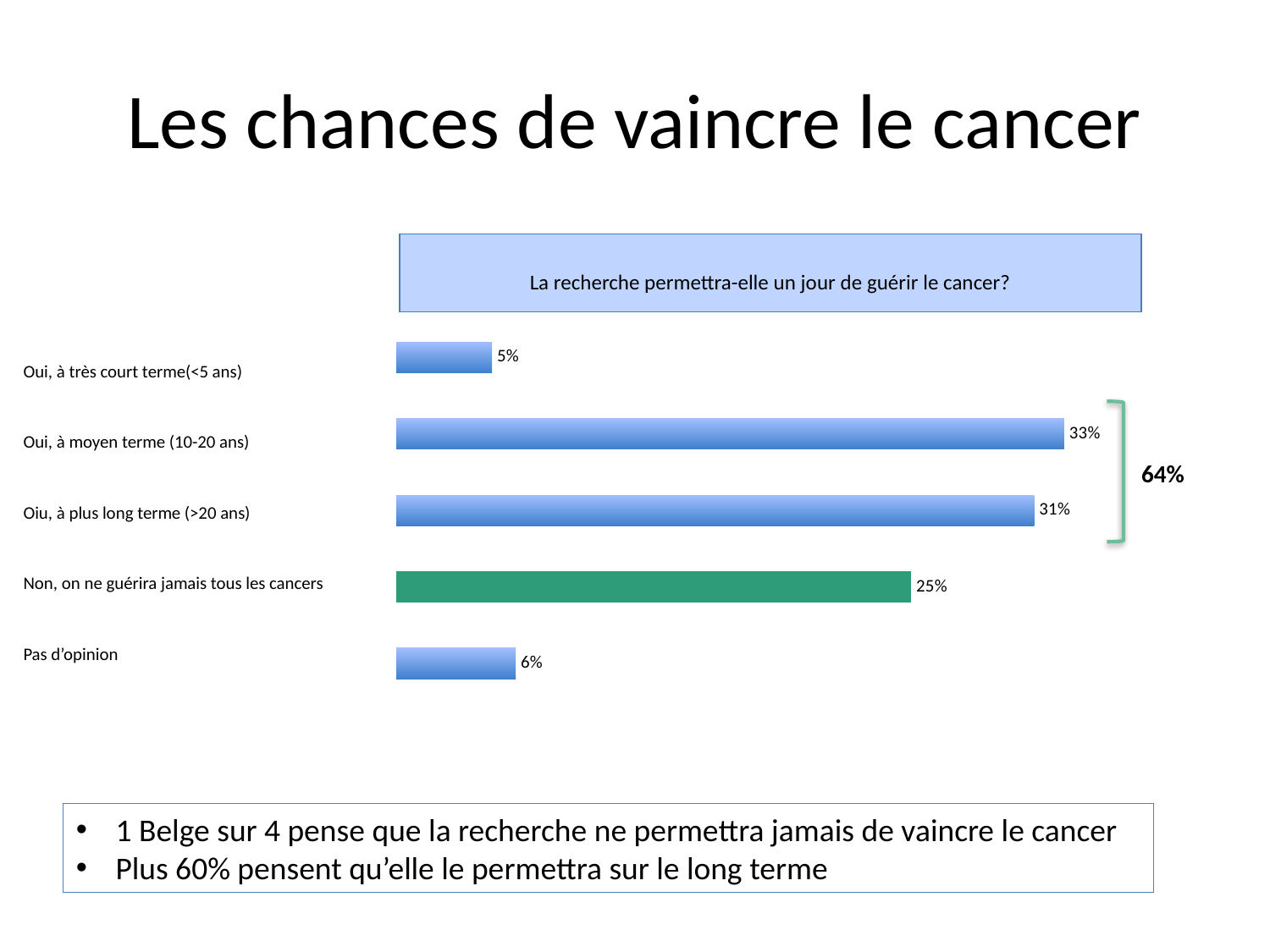
Which category has the lowest value? Oui, à très court terme(<5 ans) What is the value for "Non, on ne guérira jamais tous les cancers"? 25% What is the combined value shown by the bracket for the medium-term and longer-term "Oui" answers? 64% What kind of chart is shown on the slide? Bar chart What is the value for "Oui, à moyen terme (10-20 ans)"? 33% What is the title of the chart? La recherche permettra-elle un jour de guérir le cancer? What is the value for "Pas d'opinion"? 6% Which is larger: "Non, on ne guérira jamais tous les cancers" or "Oiu, à plus long terme (>20 ans)"? Oiu, à plus long terme (>20 ans) Which category has the highest value? Oui, à moyen terme (10-20 ans) What is the difference between "Oui, à moyen terme (10-20 ans)" and "Oiu, à plus long terme (>20 ans)"? 2% How many categories are shown in the chart? 5 What is the value for "Oui, à très court terme(<5 ans)"? 5%